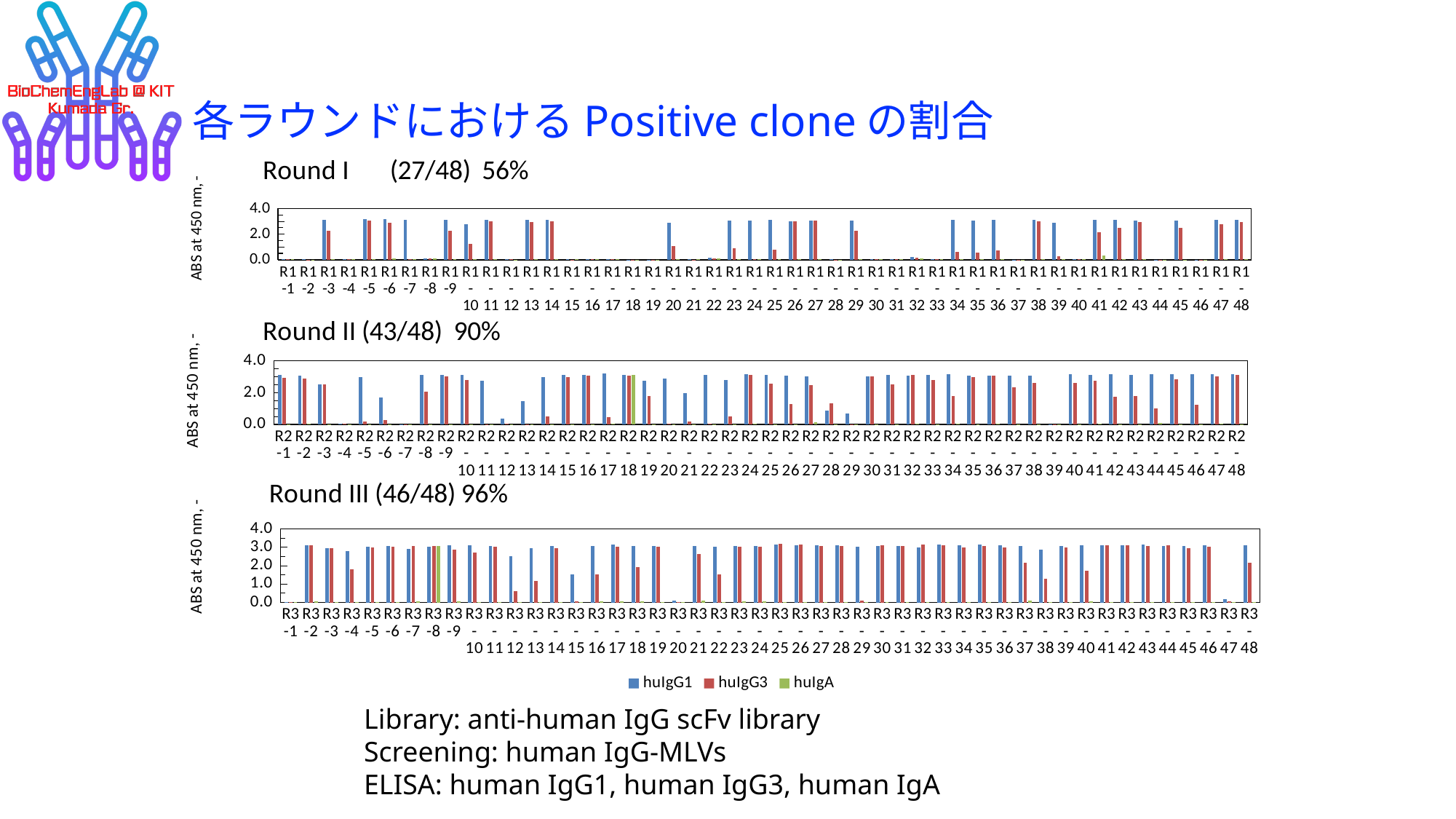
What kind of chart is the Round I chart? bar chart In the Round I chart, which series has the larger value for R1-3, huIgG1 or huIgG3? huIgG1 In the Round III chart, is the huIgG1 value for R3-20 greater or less than 1.0? less How many series does the legend at the bottom of the slide list? 3 In the Round I chart, is the huIgG1 value for R1-3 greater or less than 2.0? greater What percentage of positive clones is stated for Round II? 90% In the Round III chart, is the huIgG1 value for R3-2 greater or less than 2.0? greater What is the y-axis label of the Round II chart? ABS at 450 nm, - How many clones (categories) are plotted along the x axis of the Round III chart? 48 In the Round III chart, which series has the larger value for R3-4, huIgG1 or huIgG3? huIgG1